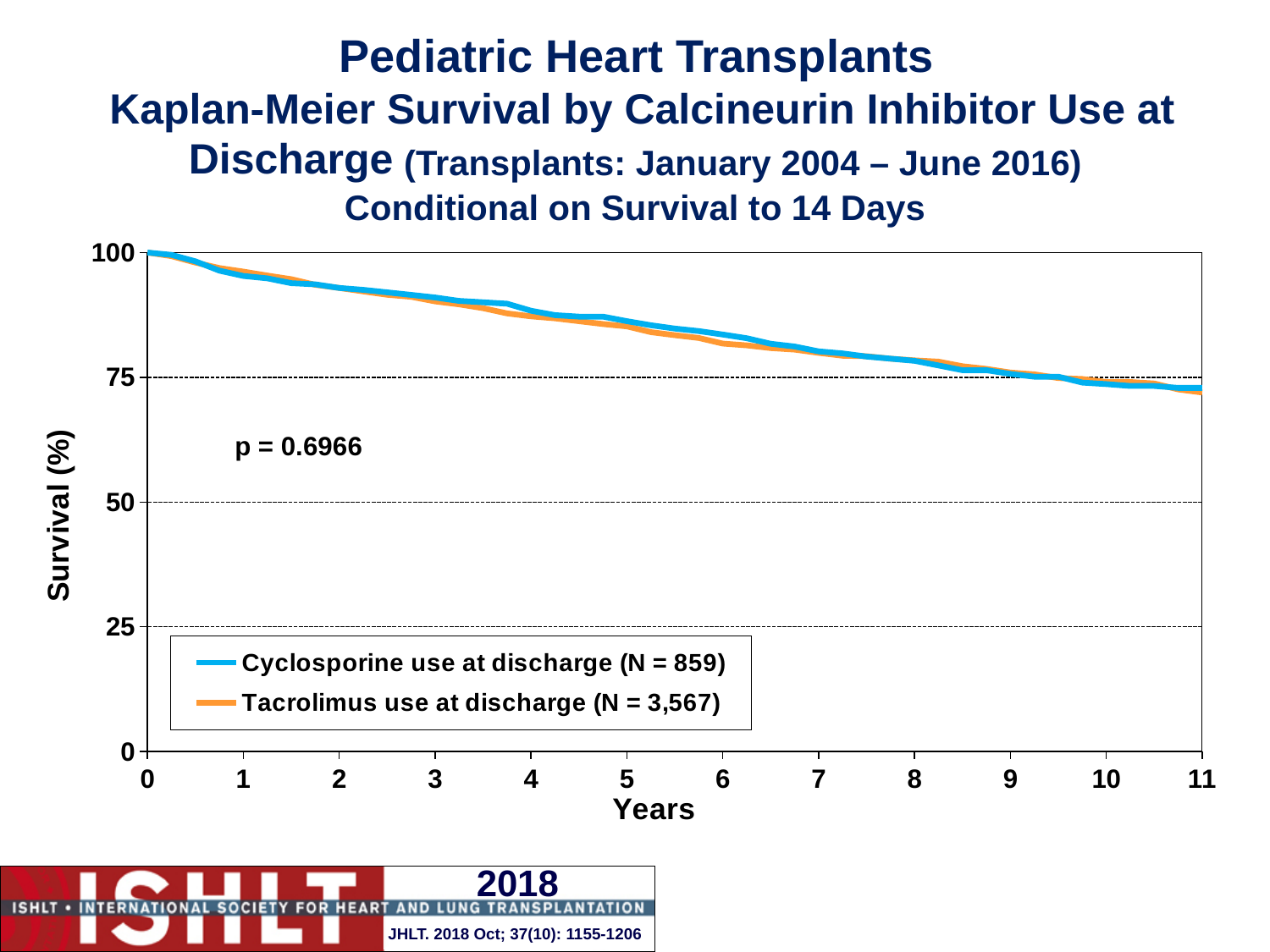
What is the N for the Tacrolimus use at discharge group shown in the legend? 3,567 What is the N for the Cyclosporine use at discharge group shown in the legend? 859 Is the survival value for Tacrolimus use at discharge at 5 years greater or less than 75? greater Which colour represents Tacrolimus use at discharge in the legend? orange How many series does the legend list? 2 What is the label of the y axis? Survival (%) What kind of chart is shown on the slide? line chart What is the maximum value shown on the Years axis? 11 Is the survival value for Tacrolimus use at discharge at 1 year greater or less than 90? greater What is the p-value printed on the chart? p = 0.6966 Is the survival value for Cyclosporine use at discharge at 3 years greater or less than 75? greater Do the survival curves rise or fall as years increase? fall